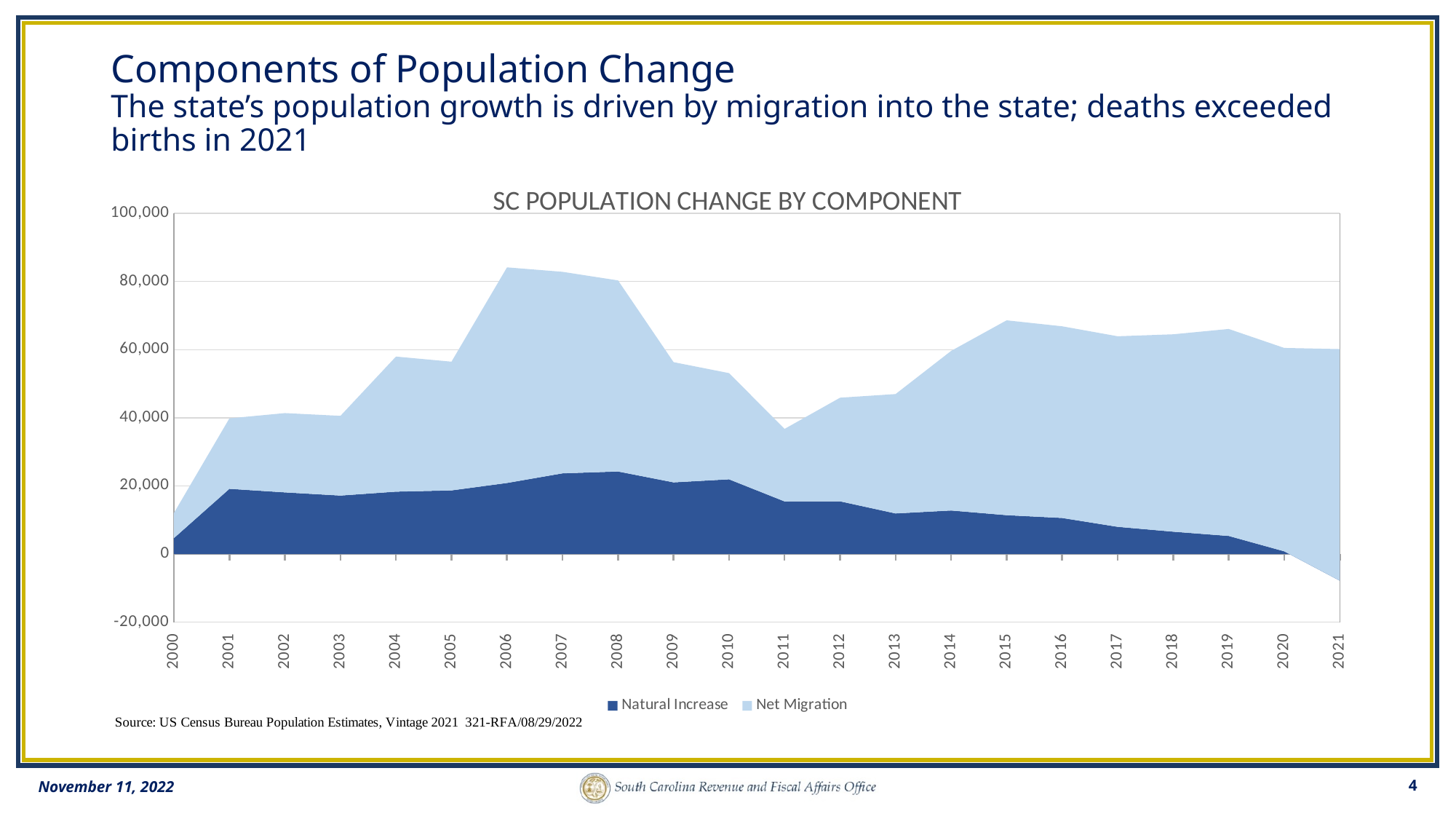
What is the title of the chart? SC POPULATION CHANGE BY COMPONENT Does the Natural Increase value rise or fall from 2008 to 2021? fall What kind of chart is shown on the slide? Stacked area chart Is the value for Natural Increase in 2021 greater or less than 0? less In which year is the Natural Increase value the lowest? 2021 Is the total population change in 2006 greater or less than 80,000? greater How many series does the legend list? 2 Is the total population change in 2011 greater or less than 40,000? less How many years are plotted along the x axis? 22 Which two series are listed in the legend? Natural Increase and Net Migration In which year is the total population change (top of the stacked area) the highest? 2006